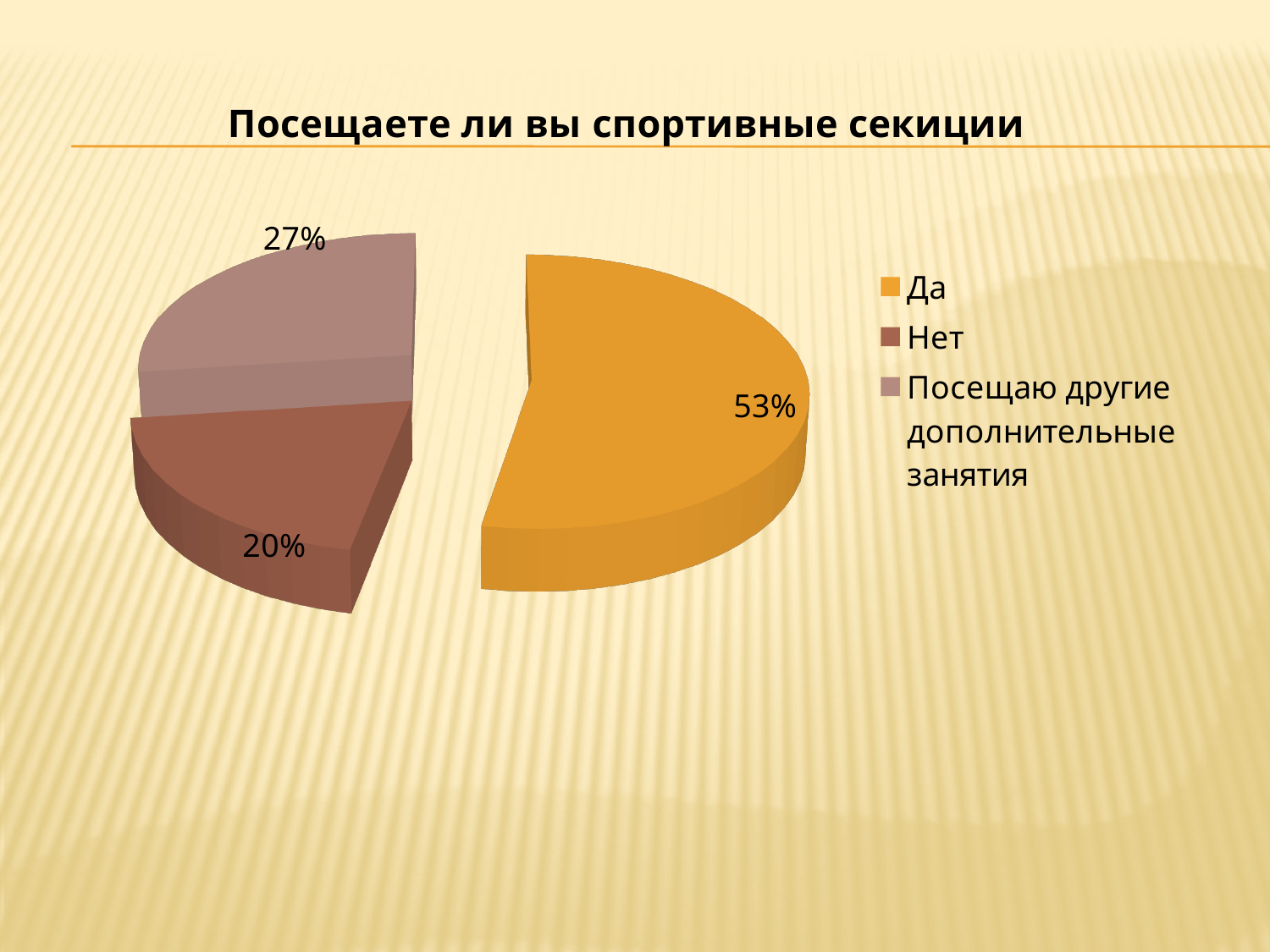
What share of the pie does "Да" have? 53% How many entries does the legend list? 3 How many categories does the pie chart have? 3 What is the title of the chart? Посещаете ли вы спортивные секиции What colour is the slice for "Да"? orange Which category has the smallest slice of the pie? Нет What share of the pie does "Нет" have? 20% What kind of chart is shown on the slide? pie chart Which category has the largest slice of the pie? Да What is the difference in percentage points between "Да" and "Нет"? 33 Which is larger, the share for "Нет" or the share for "Посещаю другие дополнительные занятия"? Посещаю другие дополнительные занятия What share of the pie does "Посещаю другие дополнительные занятия" have? 27%